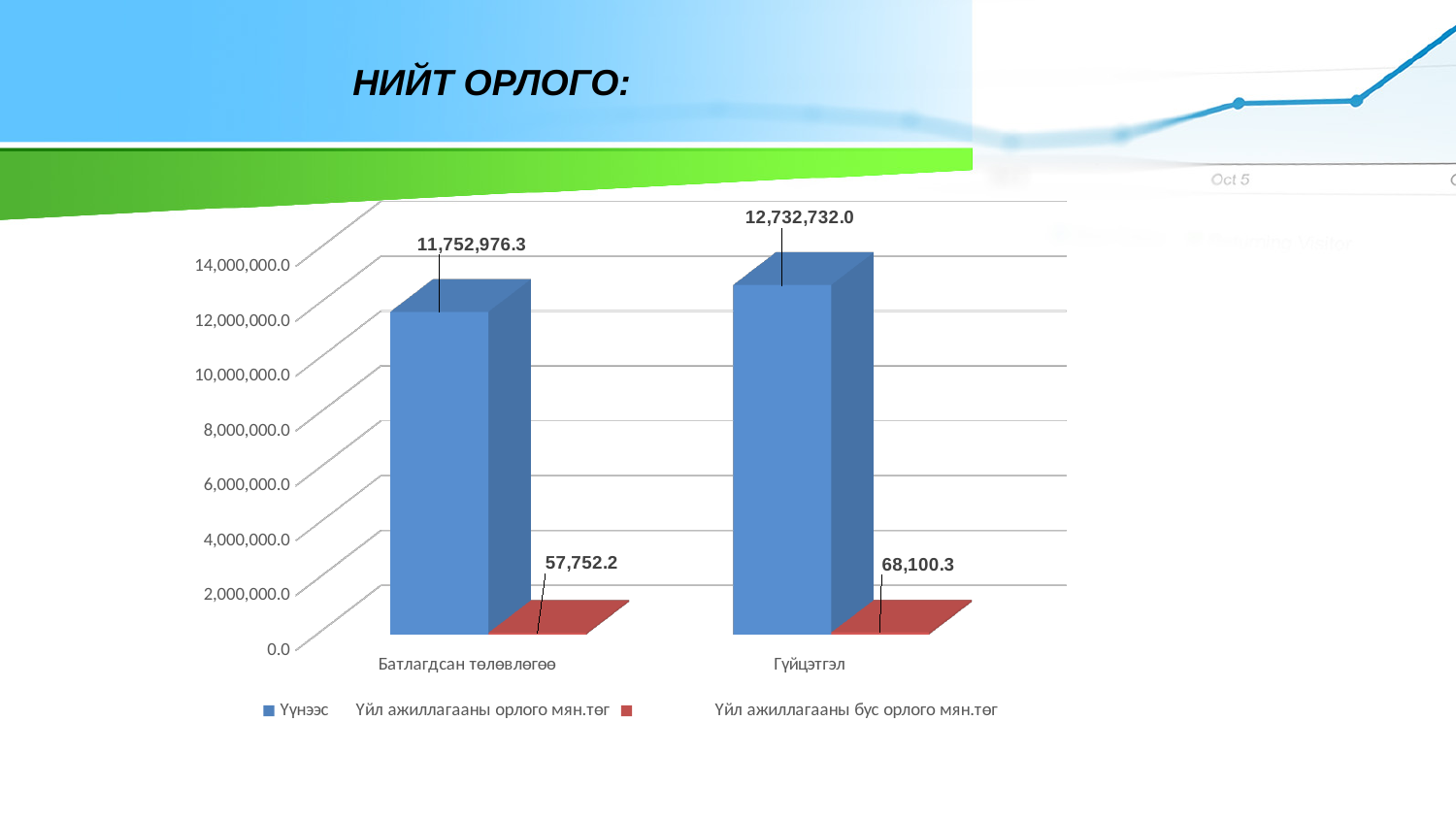
What is the value of Үйл ажиллагааны бус орлого мян.төг for Батлагдсан төлөвлөгөө? 57,752.2 What is the difference between the Үйл ажиллагааны орлого мян.төг values for Гүйцэтгэл and Батлагдсан төлөвлөгөө? 979,755.7 Which category has the higher value for Үйл ажиллагааны орлого мян.төг? Гүйцэтгэл How many categories are shown on the x axis of the chart? 2 What is the value of Үйл ажиллагааны бус орлого мян.төг for Гүйцэтгэл? 68,100.3 Which category has the lower value for Үйл ажиллагааны бус орлого мян.төг? Батлагдсан төлөвлөгөө How many series does the chart legend list? 2 What kind of chart is shown on the slide? Bar chart What is the value of Үйл ажиллагааны орлого мян.төг for Батлагдсан төлөвлөгөө? 11,752,976.3 What is the difference between the Үйл ажиллагааны бус орлого мян.төг values for Гүйцэтгэл and Батлагдсан төлөвлөгөө? 10,348.1 What is the value of Үйл ажиллагааны орлого мян.төг for Гүйцэтгэл? 12,732,732.0 Is the Үйл ажиллагааны орлого мян.төг value for Батлагдсан төлөвлөгөө greater or less than 10,000,000.0? greater